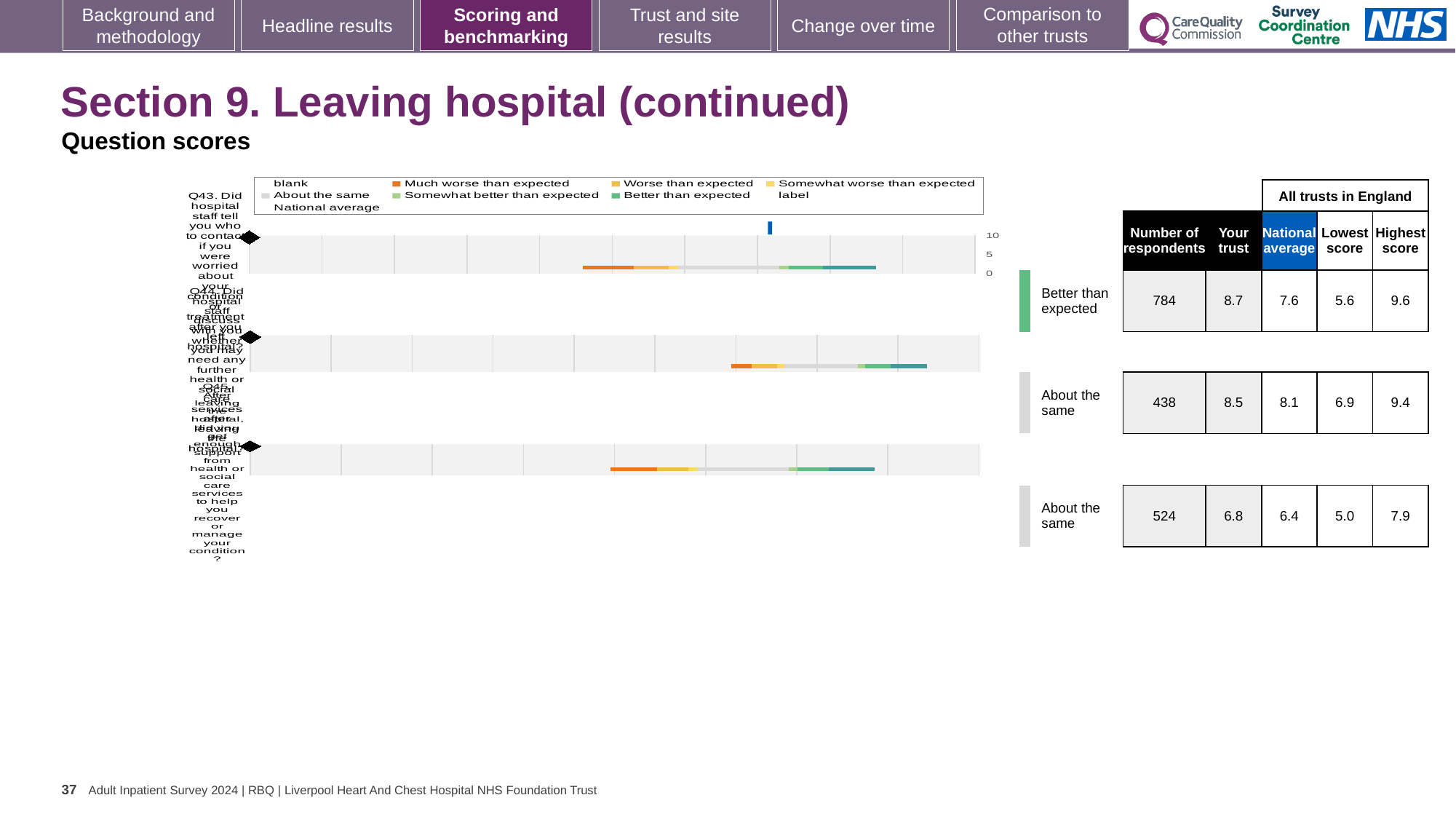
What is the highest value shown on the chart's score axis? 10 How many question rows are plotted in the chart? 3 In the table beside the chart, what is the lowest score for the middle question row? 6.9 For the bottom question row, what is the difference between the 'Your trust' score and the national average? 0.4 Which question row has the lowest number of respondents? the middle row (438) In the table beside the chart, what is the 'Your trust' score for the top question row? 8.7 For the top question row, which is larger: the 'Your trust' score or the national average? Your trust Which legend entry is shown in orange? Much worse than expected In the table beside the chart, what is the number of respondents for the top question row? 784 In the table beside the chart, what is the national average for the middle question row? 8.1 In the table beside the chart, what is the highest score for the bottom question row? 7.9 What kind of chart is shown on the slide? bar chart